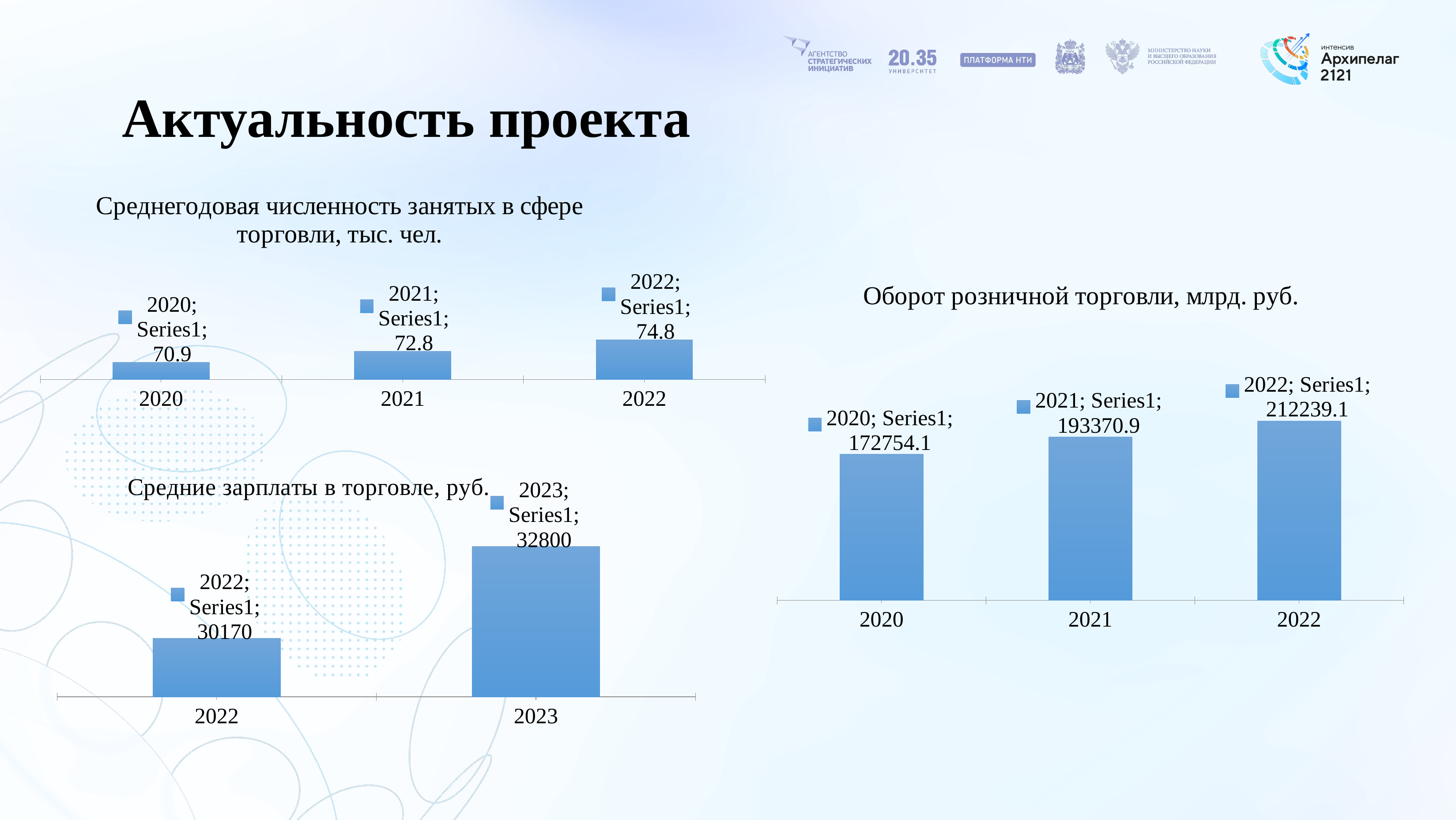
In the chart 'Среднегодовая численность занятых в сфере торговли, тыс. чел.', which year has the highest value? 2022 In the chart 'Среднегодовая численность занятых в сфере торговли, тыс. чел.', what is the value for 2021? 72.8 In the chart 'Среднегодовая численность занятых в сфере торговли, тыс. чел.', how many years are plotted? 3 In the chart 'Средние зарплаты в торговле, руб.', what is the difference between the 2023 and 2022 values? 2630 In the chart 'Оборот розничной торговли, млрд. руб.', what is the value for 2021? 193370.9 What type of chart is 'Оборот розничной торговли, млрд. руб.'? bar chart In the chart 'Оборот розничной торговли, млрд. руб.', which year has the lowest value? 2020 In the chart 'Оборот розничной торговли, млрд. руб.', what is the difference between the 2022 and 2020 values? 39485 In the chart 'Средние зарплаты в торговле, руб.', what is the value for 2022? 30170 In the chart 'Средние зарплаты в торговле, руб.', how many bars are shown? 2 In the chart 'Оборот розничной торговли, млрд. руб.', do the values rise or fall from 2020 to 2022? rise In the chart 'Среднегодовая численность занятых в сфере торговли, тыс. чел.', what is the difference between the 2022 and 2020 values? 3.9